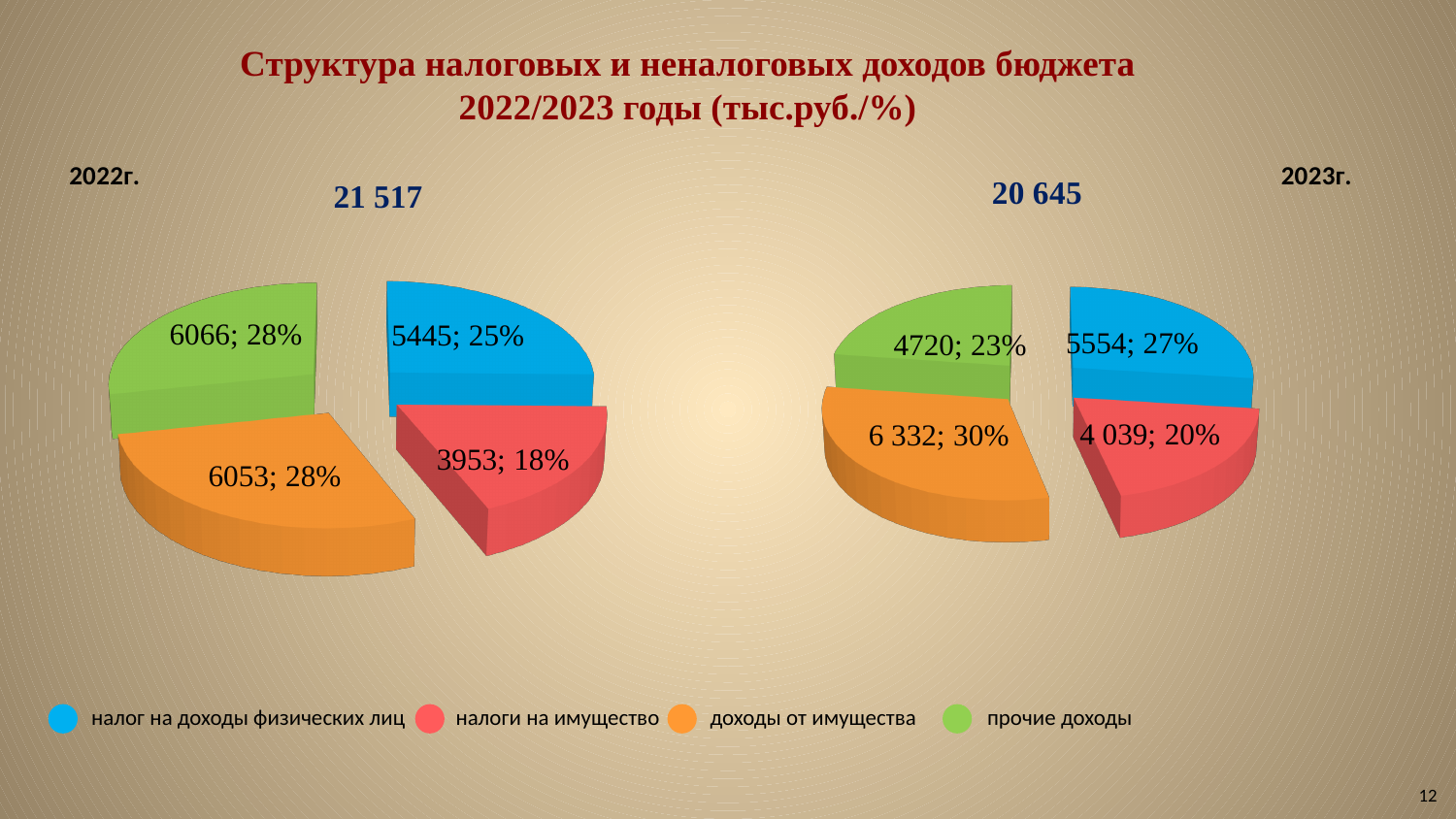
In the 2022г. pie chart, which category has the smallest slice? налоги на имущество In the 2023г. pie chart, what is the value for доходы от имущества? 6 332 What is the difference between the value for налоги на имущество in the 2023г. pie chart and in the 2022г. pie chart? 86 In the 2022г. pie chart, what share does налоги на имущество have? 18% What total is shown above the 2023г. pie chart? 20 645 What type of charts are shown on the slide? Pie charts In the 2022г. pie chart, what is the value for налог на доходы физических лиц? 5445 In the 2023г. pie chart, which category has the largest slice? доходы от имущества How many slices does each pie chart have? 4 In the 2023г. pie chart, which category has the smallest slice? налоги на имущество In the 2023г. pie chart, which is larger: налог на доходы физических лиц or прочие доходы? налог на доходы физических лиц In the 2023г. pie chart, what share does прочие доходы have? 23%